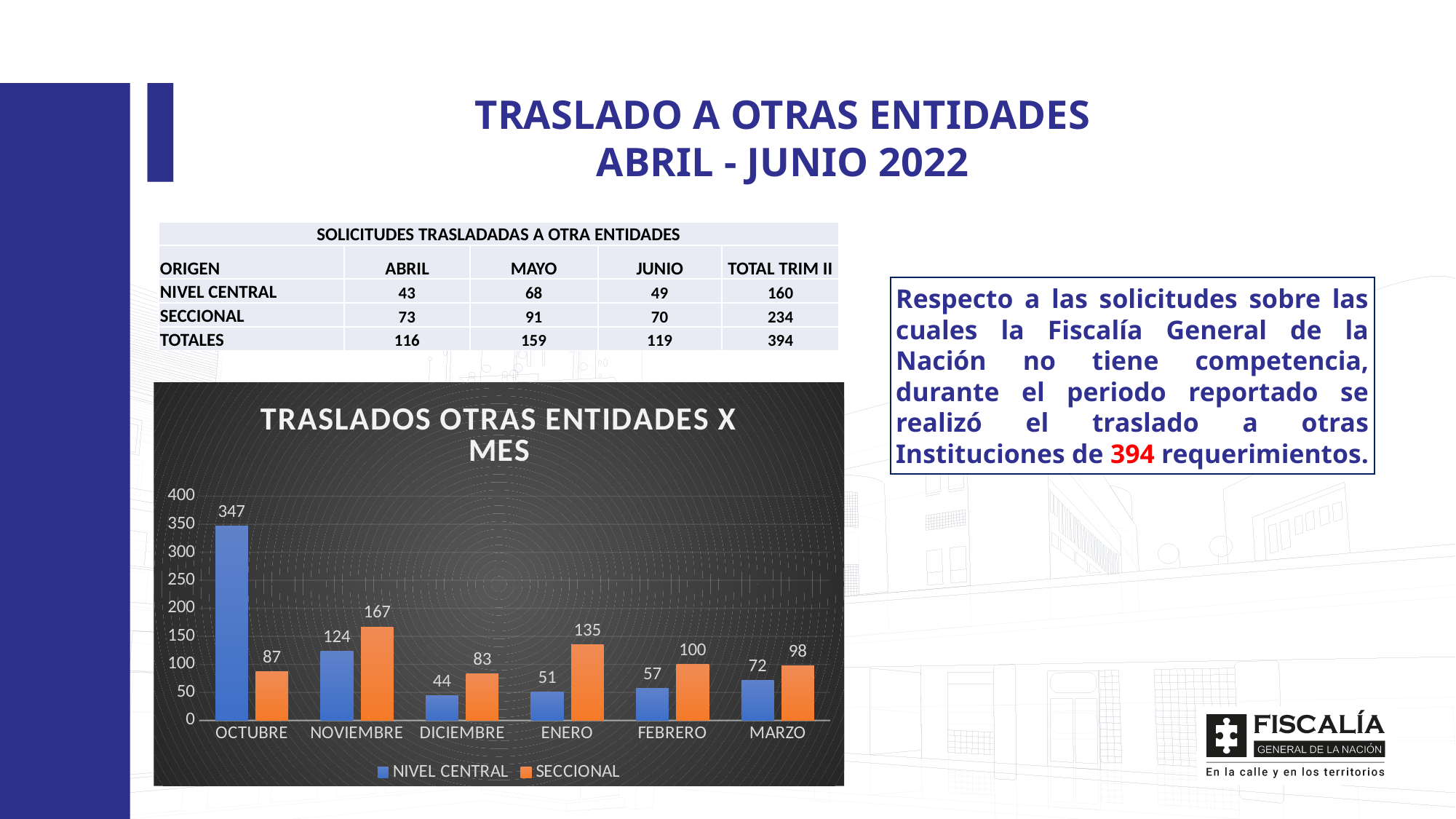
What is the NIVEL CENTRAL value for OCTUBRE in the chart? 347 How many series does the chart legend list? 2 Which month has the lowest NIVEL CENTRAL value in the chart? DICIEMBRE What is the title of the chart? TRASLADOS OTRAS ENTIDADES X MES Which month has the lowest SECCIONAL value in the chart? DICIEMBRE In FEBRERO, which series has the larger value, NIVEL CENTRAL or SECCIONAL? SECCIONAL Which month has the highest NIVEL CENTRAL value in the chart? OCTUBRE How many months are shown on the x axis of the chart? 6 What is the difference between the NIVEL CENTRAL and SECCIONAL values for OCTUBRE? 260 What type of chart is shown on the slide? Bar chart What is the SECCIONAL value for ENERO in the chart? 135 What is the SECCIONAL value for NOVIEMBRE in the chart? 167